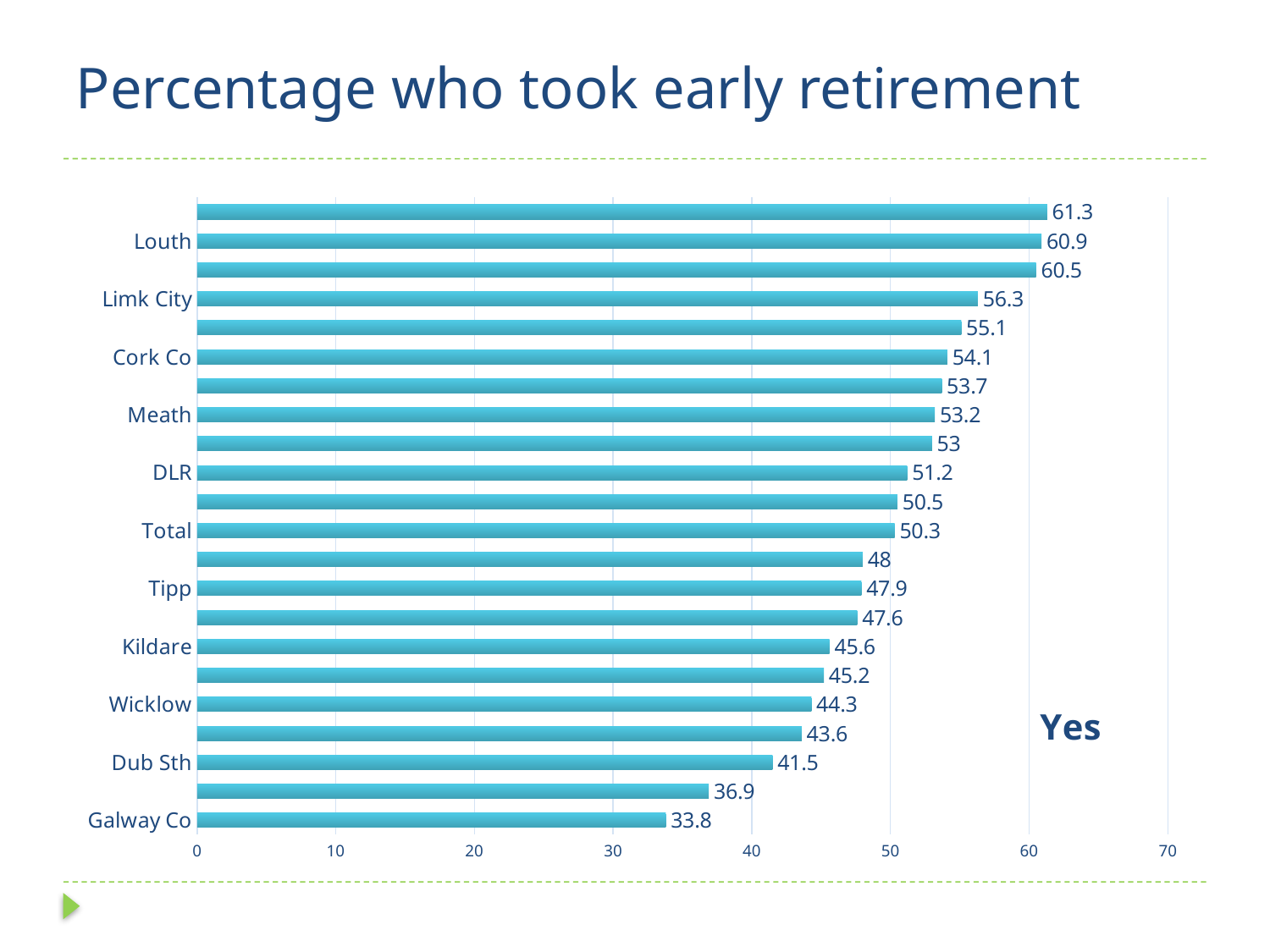
What is the value for Total? 50.3 How many bars are plotted in the chart? 22 What is the difference between the values for Louth and Galway Co? 27.1 Which labelled category has the lowest value? Galway Co Is the value for DLR greater or less than 50? greater What is the difference between the values for Cork Co and Meath? 0.9 Which is larger, the value for Kildare or the value for Wicklow? Kildare What is the value for Dub Sth? 41.5 What kind of chart is shown on the slide? Bar chart What is the value for Louth? 60.9 What is the value for Limk City? 56.3 What is the value for Galway Co? 33.8